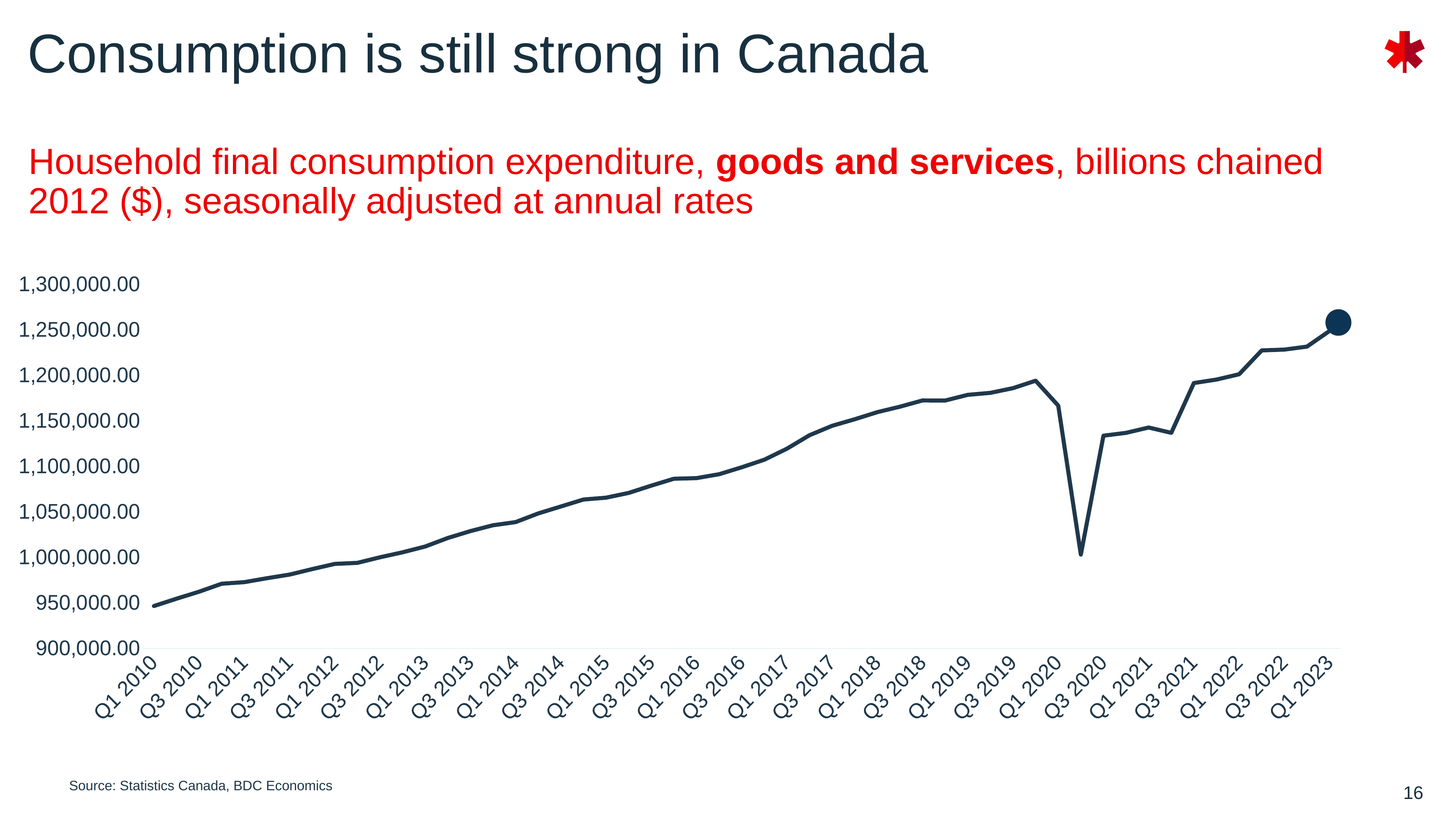
What is the highest value shown on the y axis of the chart? 1,300,000.00 Is the value for Q3 2018 greater or less than 1,150,000.00? greater Which quarter has the lowest household final consumption expenditure on the chart? Q1 2010 Is the value for Q1 2015 greater or less than 1,050,000.00? greater Does household consumption expenditure generally rise or fall from Q1 2010 to Q1 2023? rise Is the value for Q1 2020 greater or less than 1,200,000.00? less Which is larger, the value for Q1 2020 or the value for Q3 2020? Q1 2020 What kind of chart is shown on the slide? line chart Which quarter has the highest household final consumption expenditure on the chart? Q1 2023 Which is larger, the value for Q1 2019 or the value for Q1 2021? Q1 2019